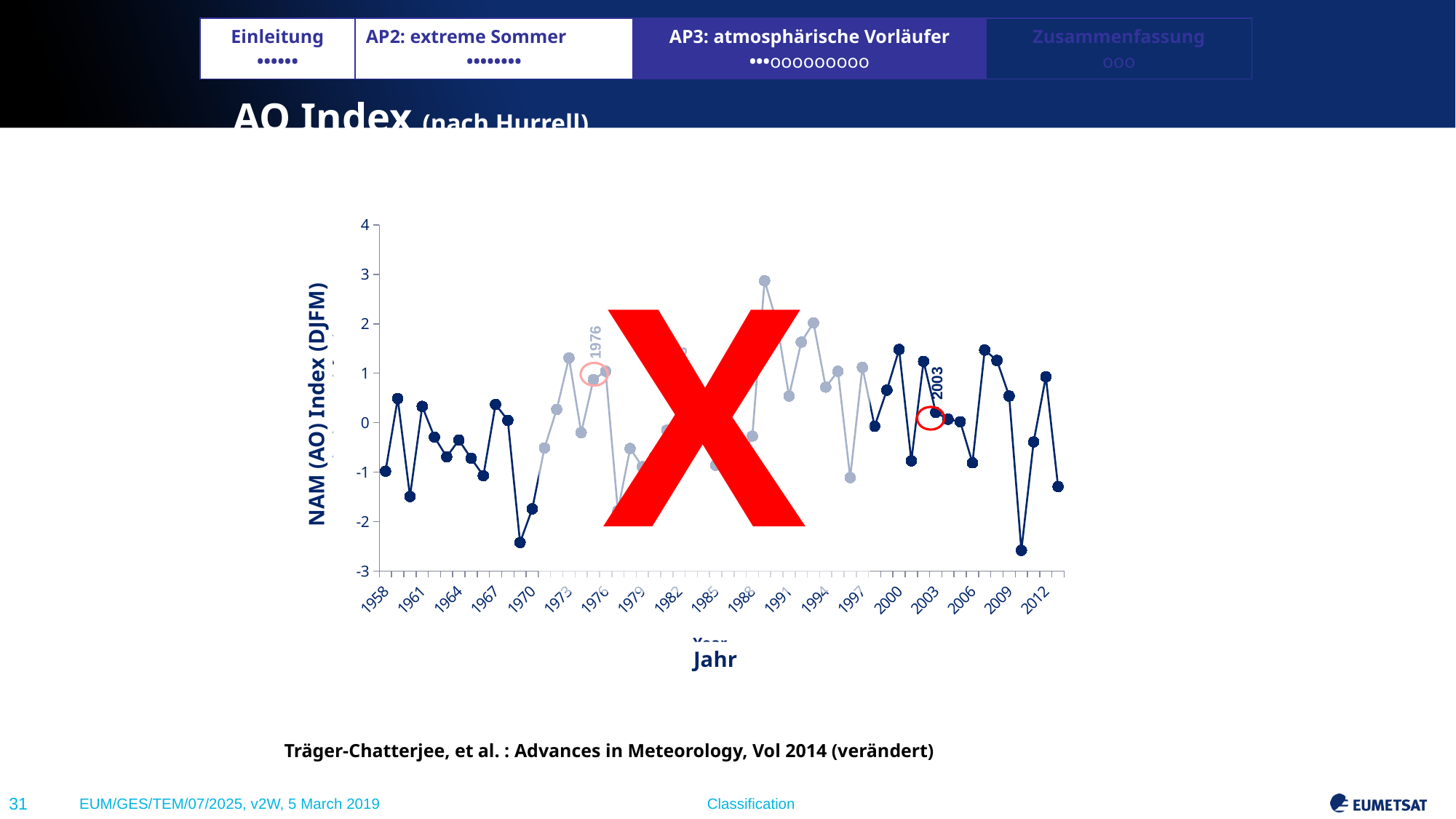
Which year has the larger value, 2000 or 2003? 2000 Is the value for 2000 greater or less than 1? greater Is the value for 1973 greater or less than 1? greater Is the value for 2003 greater or less than 1? less What is the label of the y axis? NAM (AO) Index (DJFM) Which two years are highlighted with circles on the chart? 1976 and 2003 What kind of chart is shown on the slide? line chart Which year has the larger value, 1970 or 1973? 1973